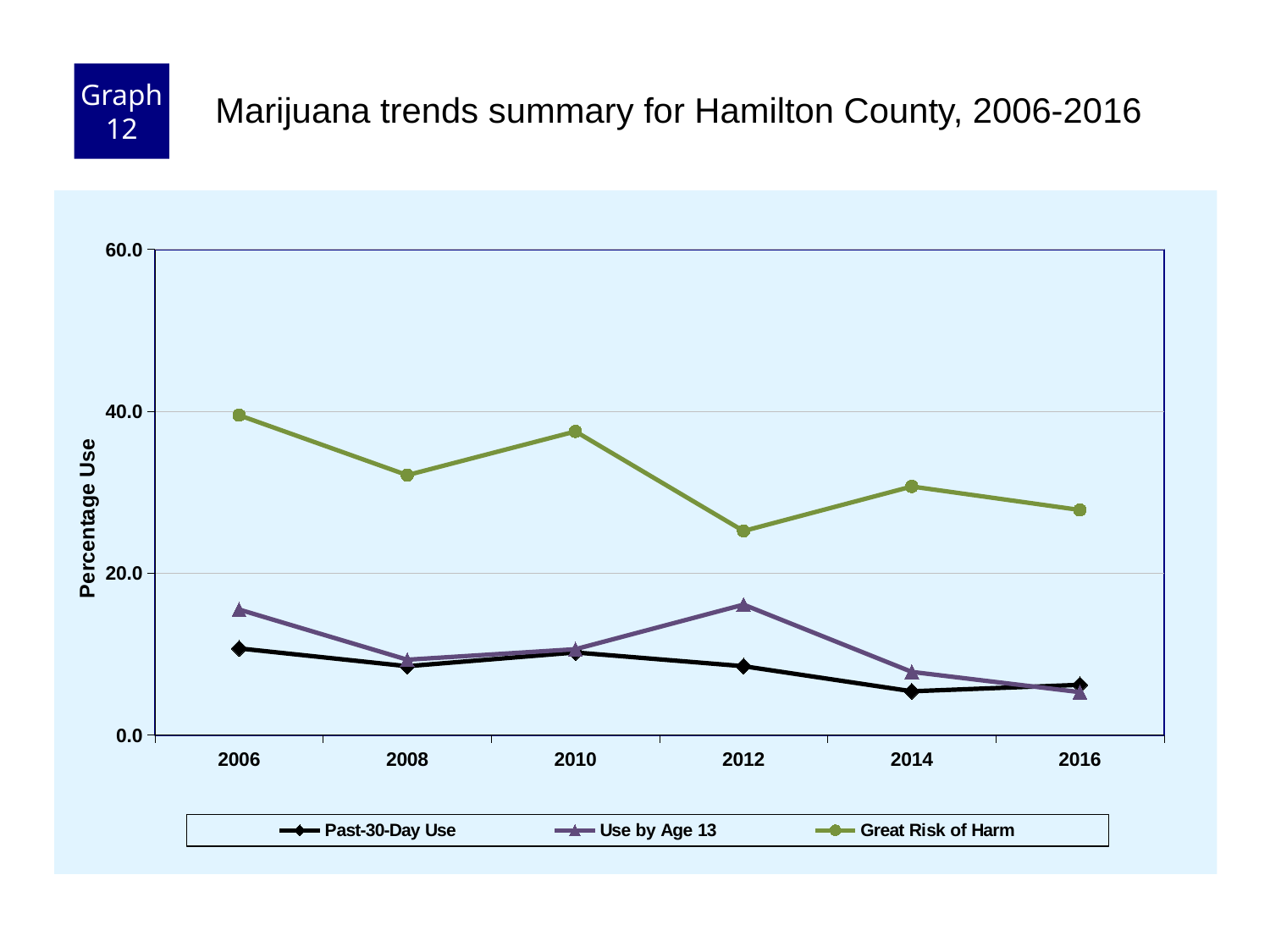
In which year is the Great Risk of Harm value lowest? 2012 In which year is the Use by Age 13 value lowest? 2016 Is the Great Risk of Harm value for 2008 greater or less than 40? less How many years are plotted along the x axis? 6 Is the Use by Age 13 value for 2006 greater or less than 20? less What kind of chart is shown on the slide? Line chart How many series does the legend list? 3 Which series has the highest values across all years? Great Risk of Harm In 2012, which is larger: Use by Age 13 or Past-30-Day Use? Use by Age 13 Is the Great Risk of Harm value for 2012 greater or less than 20? greater In which year is the Great Risk of Harm value highest? 2006 Does the Great Risk of Harm series overall rise or fall from 2006 to 2016? Fall